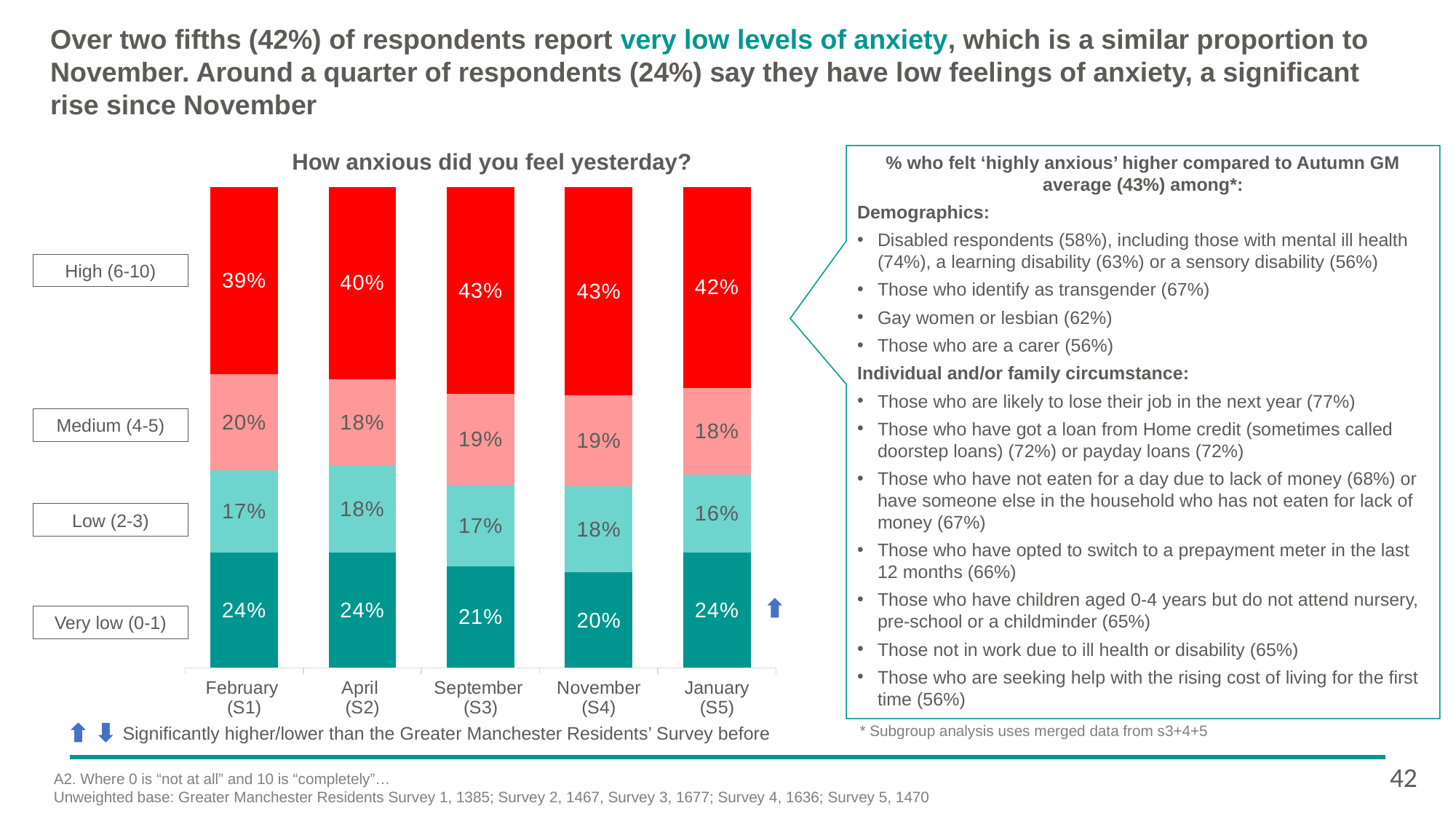
What is the 'Medium (4-5)' value for February (S1)? 20% What is the 'High (6-10)' value for January (S5)? 42% Which survey wave has the lowest 'Very low (0-1)' value? November (S4) How many survey waves (bars) are shown on the x axis of the chart? 5 What is the 'Low (2-3)' value for April (S2)? 18% What is the title of the chart? How anxious did you feel yesterday? Is the 'Very low (0-1)' value larger in January (S5) or in September (S3)? January (S5) Which survey wave has the lowest 'High (6-10)' value? February (S1) How many anxiety categories (series) are labelled on the chart? 4 What is the difference between the 'High (6-10)' value in September (S3) and in February (S1)? 4 percentage points What is the 'Very low (0-1)' value for November (S4)? 20% What kind of chart is shown under the title 'How anxious did you feel yesterday?'? Stacked bar chart